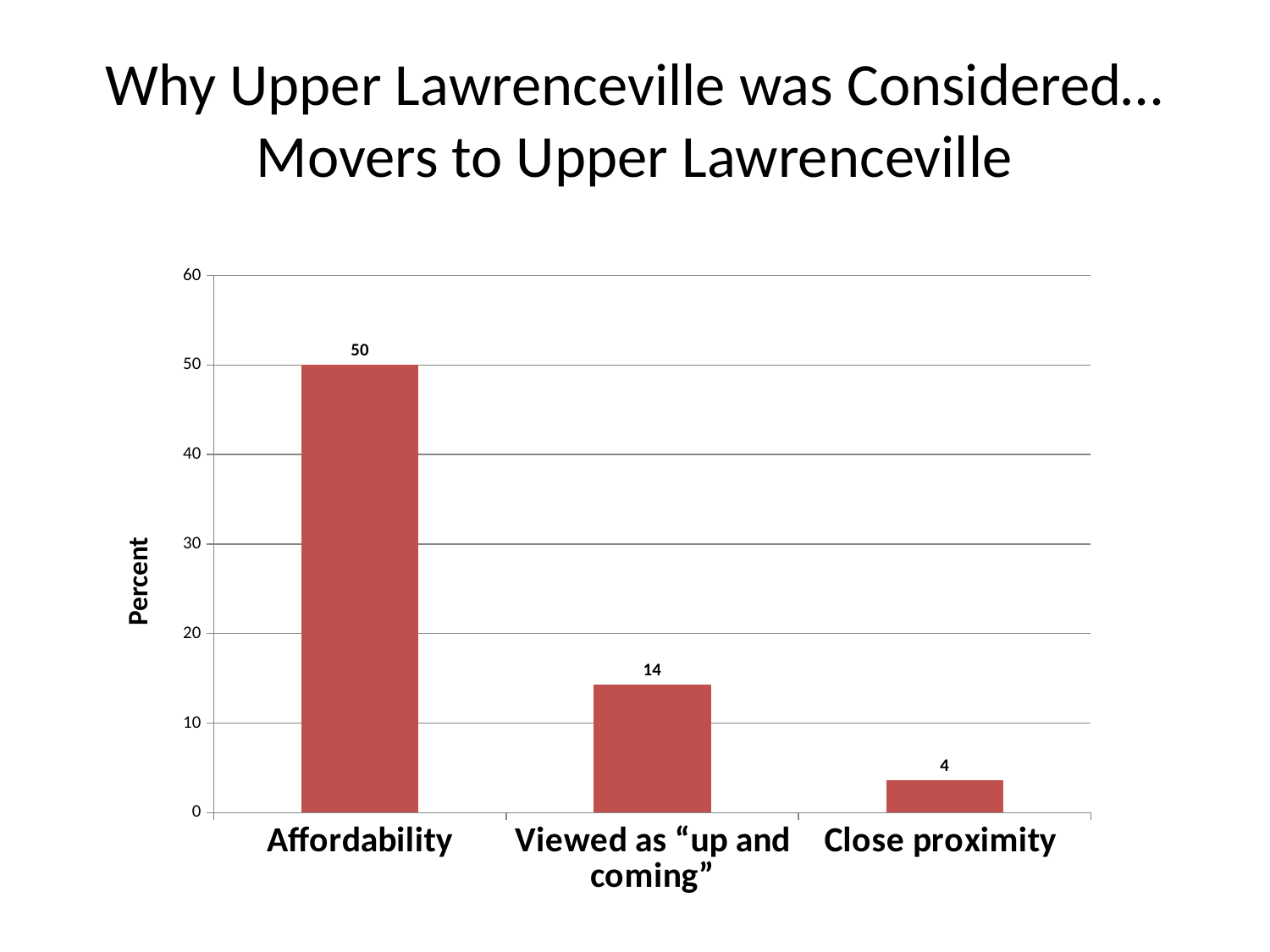
Which category has the lowest value? Close proximity How many categories are shown in the chart? 3 What is the label of the vertical axis? Percent Which category has the highest value? Affordability Is the value for Affordability greater or less than 40? greater What is the difference between the values for Viewed as "up and coming" and Close proximity? 10 What is the value for Affordability? 50 What is the value for Viewed as "up and coming"? 14 What kind of chart is shown on the slide? bar chart What is the difference between the values for Affordability and Viewed as "up and coming"? 36 What is the value for Close proximity? 4 Which is larger, the value for Viewed as "up and coming" or the value for Close proximity? Viewed as "up and coming"